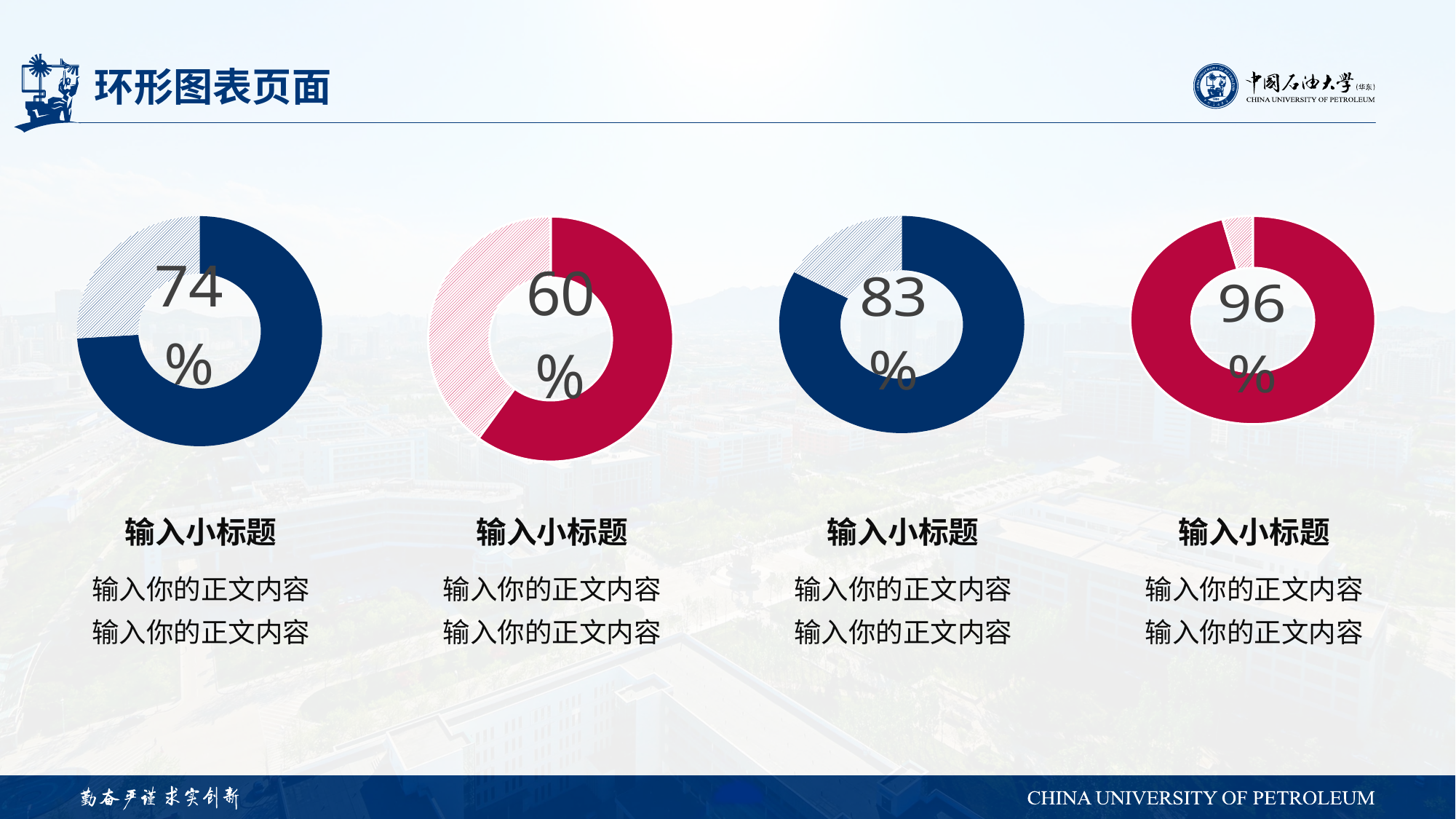
What kind of chart is used on this slide? Donut chart Which of the four donut charts shows the lowest percentage? The second chart from the left (60%) What value is shown in the centre of the leftmost donut chart? 74% What colour is the filled portion of the rightmost donut chart? Red What value is shown in the centre of the rightmost donut chart? 96% Which is larger: the value in the leftmost donut chart or the value in the second donut chart from the left? The leftmost chart (74%) What is the difference between the value in the rightmost donut chart and the value in the leftmost donut chart? 22% What is the difference between the value in the third donut chart and the value in the second donut chart? 23% How many donut charts are on the slide? 4 What value is shown in the centre of the third donut chart from the left? 83% What value is shown in the centre of the second donut chart from the left? 60% Which of the four donut charts shows the highest percentage? The rightmost chart (96%)